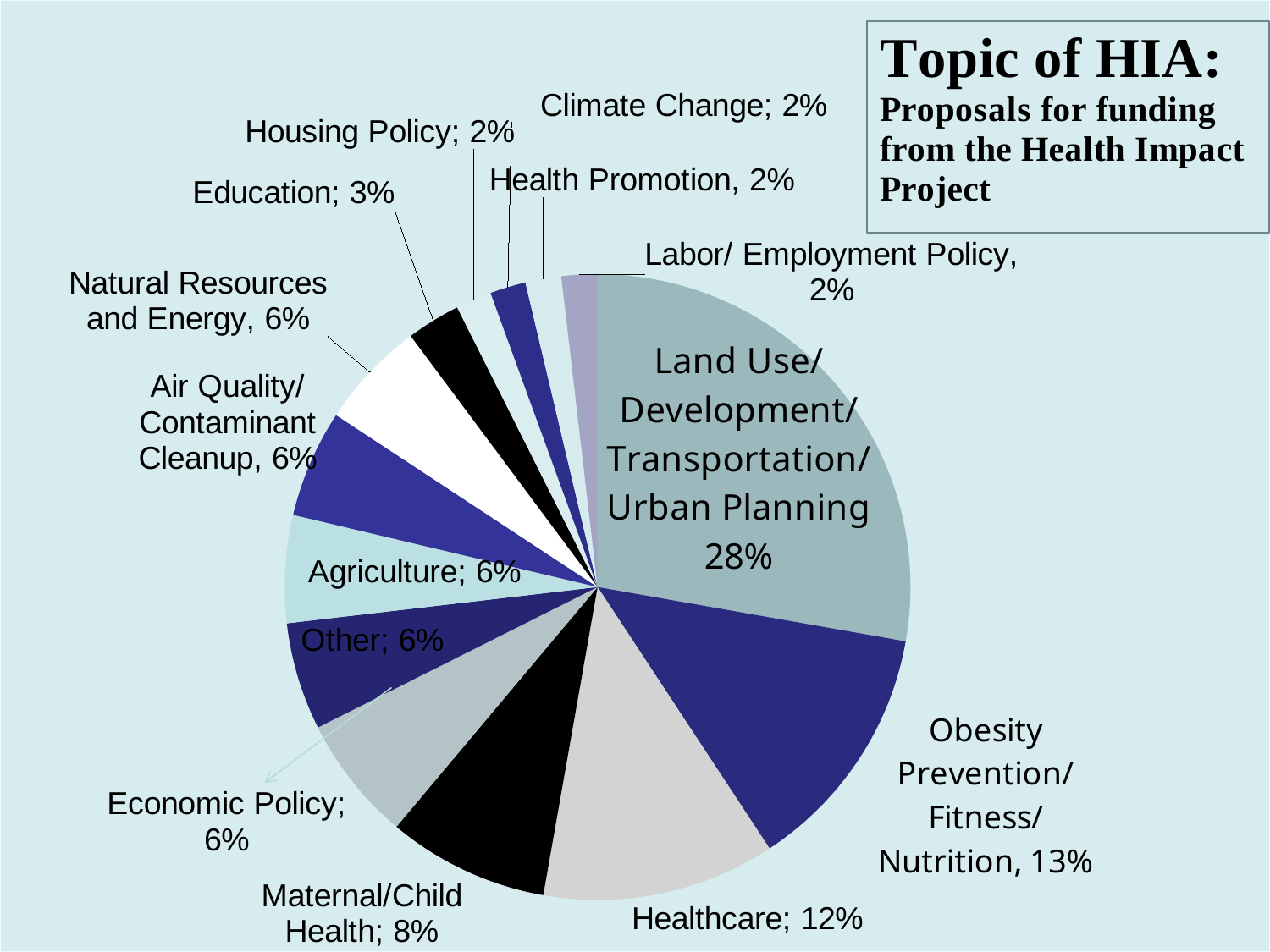
How many categories (slices) does the pie chart have? 14 What share of the pie does Land Use/Development/Transportation/Urban Planning represent? 28% Which is larger, Healthcare or Maternal/Child Health? Healthcare What is the difference between the Land Use/Development/Transportation/Urban Planning slice and the Obesity Prevention/Fitness/Nutrition slice? 15% What is the value for Obesity Prevention/Fitness/Nutrition? 13% What is the value for Healthcare? 12% Which category has the largest slice of the pie? Land Use/Development/Transportation/Urban Planning What is the value for Education? 3% What is the value for Maternal/Child Health? 8% What is the title of the chart? Topic of HIA: Proposals for funding from the Health Impact Project What kind of chart is shown on the slide? Pie chart What is the difference between Healthcare and Maternal/Child Health? 4%